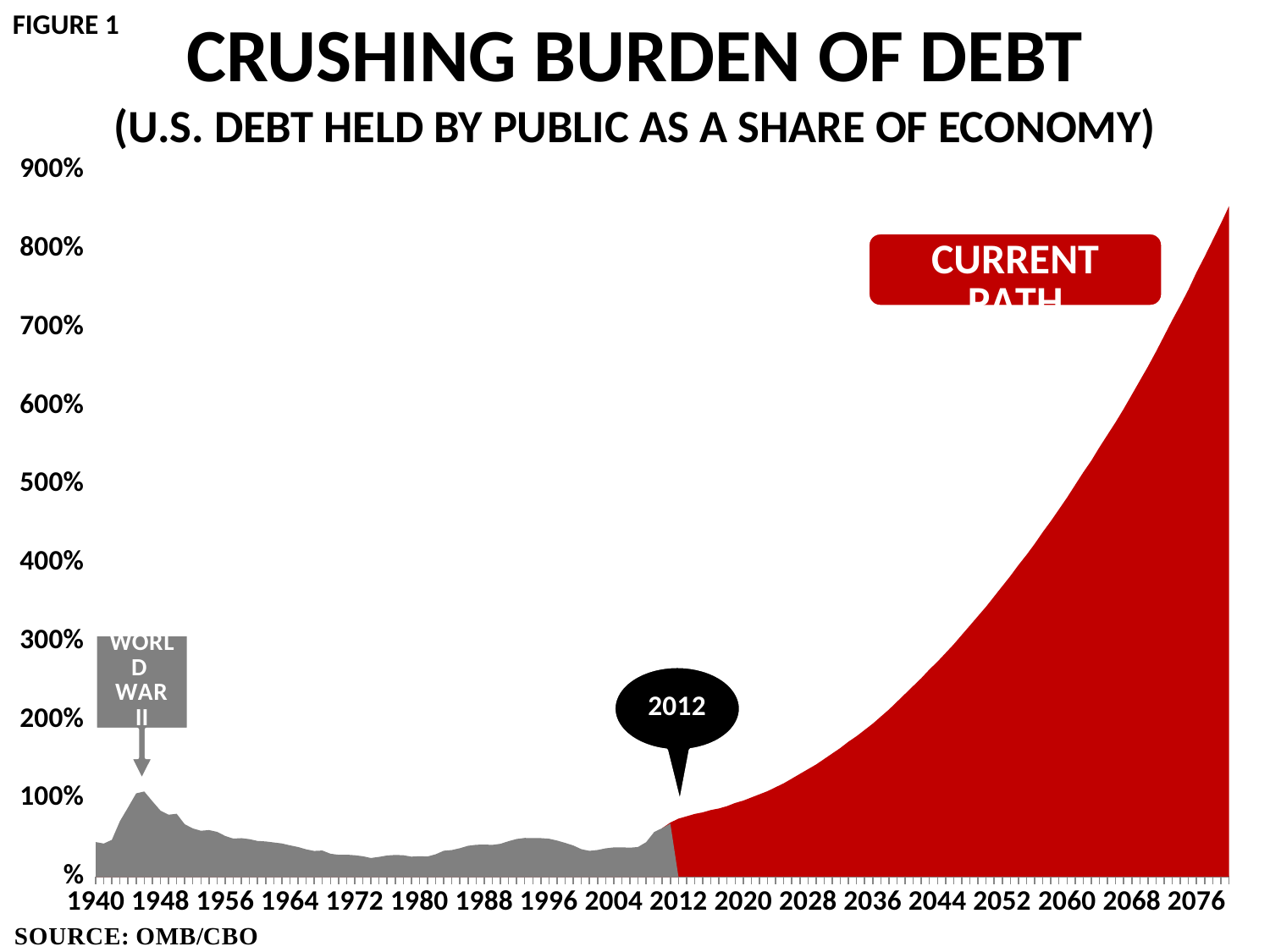
Which is larger, the value for 2076 or the value for 1948? 2076 Do the values rise or fall along the x axis from 2012 to 2076? rise How many year labels are shown on the x axis? 18 What is the title of the chart? CRUSHING BURDEN OF DEBT Is the value for 2076 greater or less than 700%? greater Is the value for 2044 greater or less than 200%? greater Which is larger, the value for 1948 or the value for 2004? 1948 Is the value for 1948 greater or less than 200%? less What label appears on the red shaded portion of the chart? CURRENT PATH What kind of chart is shown on the slide? Area chart